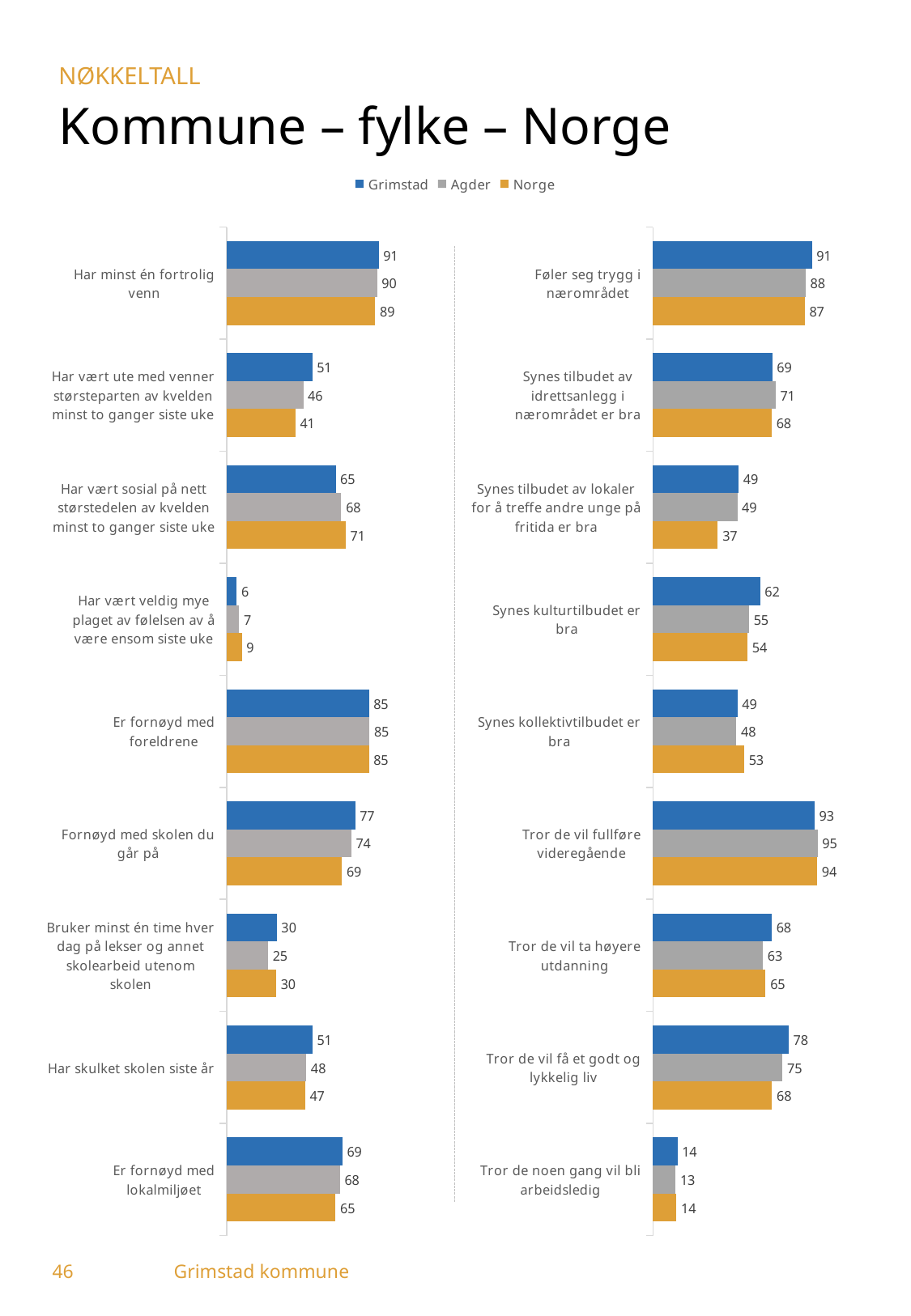
In the left chart, for "Har vært sosial på nett størstedelen av kvelden minst to ganger siste uke", which is larger: the Grimstad value or the Norge value? Norge In the right chart, for "Synes kulturtilbudet er bra", which is larger: the Grimstad value or the Agder value? Grimstad In the left chart, which category has the lowest Norge value? Har vært veldig mye plaget av følelsen av å være ensom siste uke How many categories does the left chart show? 9 How many series does the legend list? 3 In the right chart, which category has the highest Grimstad value? Tror de vil fullføre videregående In the right chart, what is the difference between the Grimstad and Norge values for "Tror de vil få et godt og lykkelig liv"? 10 What kind of chart is used on this slide? Bar chart In the left chart, what is the difference between the Grimstad and Norge values for "Har vært ute med venner størsteparten av kvelden minst to ganger siste uke"? 10 In the left chart, what is the Agder value for "Bruker minst én time hver dag på lekser og annet skolearbeid utenom skolen"? 25 In the left chart, what is the Grimstad value for "Har minst én fortrolig venn"? 91 In the right chart, what is the Norge value for "Synes tilbudet av lokaler for å treffe andre unge på fritida er bra"? 37